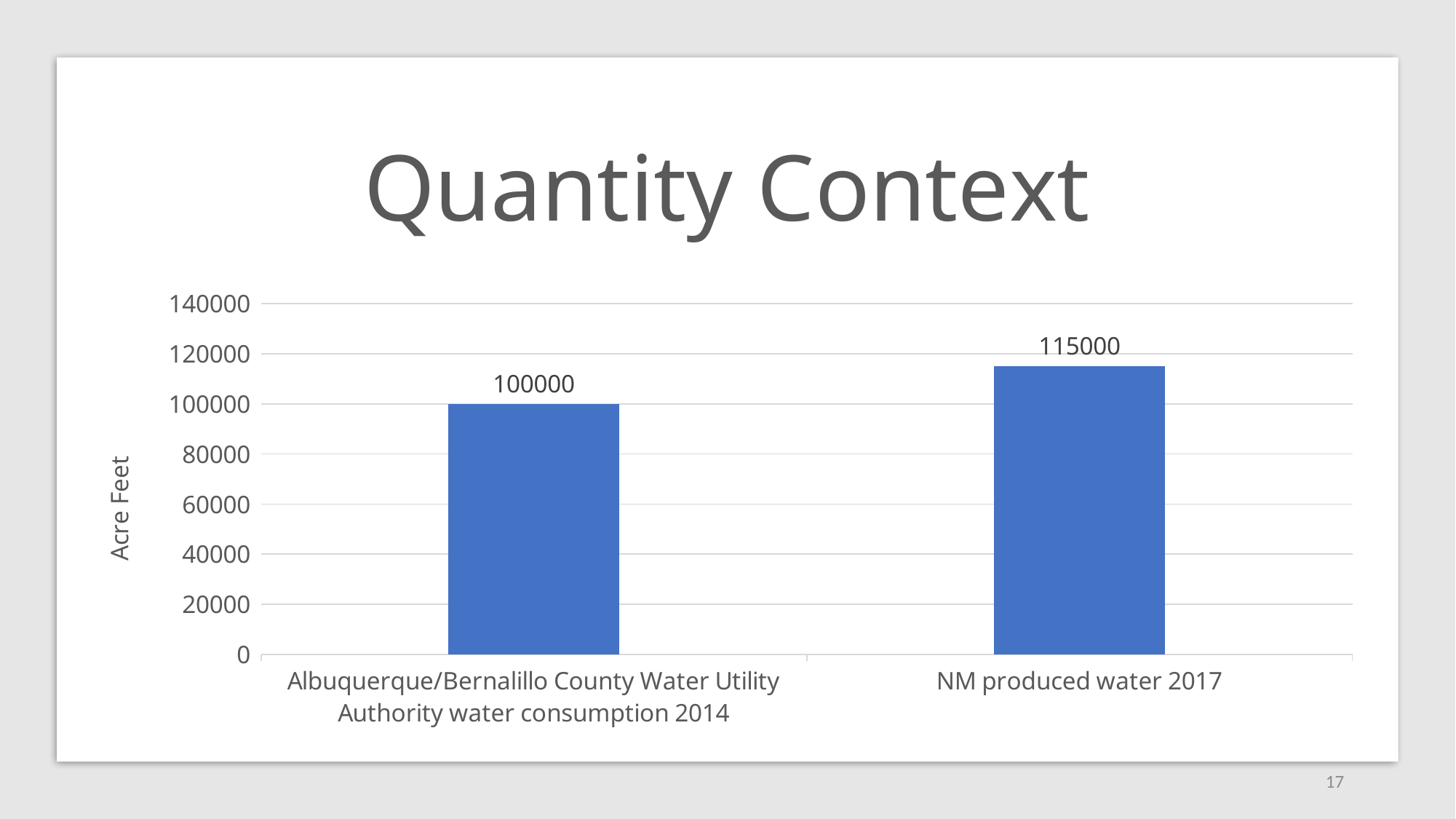
Which category has the highest value? NM produced water 2017 Which is larger: NM produced water 2017 or Albuquerque/Bernalillo County Water Utility Authority water consumption 2014? NM produced water 2017 Is the value for Albuquerque/Bernalillo County Water Utility Authority water consumption 2014 greater or less than 80000? greater What is the difference between NM produced water 2017 and Albuquerque/Bernalillo County Water Utility Authority water consumption 2014? 15000 What is the value for Albuquerque/Bernalillo County Water Utility Authority water consumption 2014? 100000 What is the label on the vertical axis? Acre Feet Which category has the lowest value? Albuquerque/Bernalillo County Water Utility Authority water consumption 2014 Is the value for NM produced water 2017 greater or less than 120000? less How many categories are shown in the chart? 2 What is the value for NM produced water 2017? 115000 What kind of chart is shown on the slide? bar chart What is the title of the slide? Quantity Context